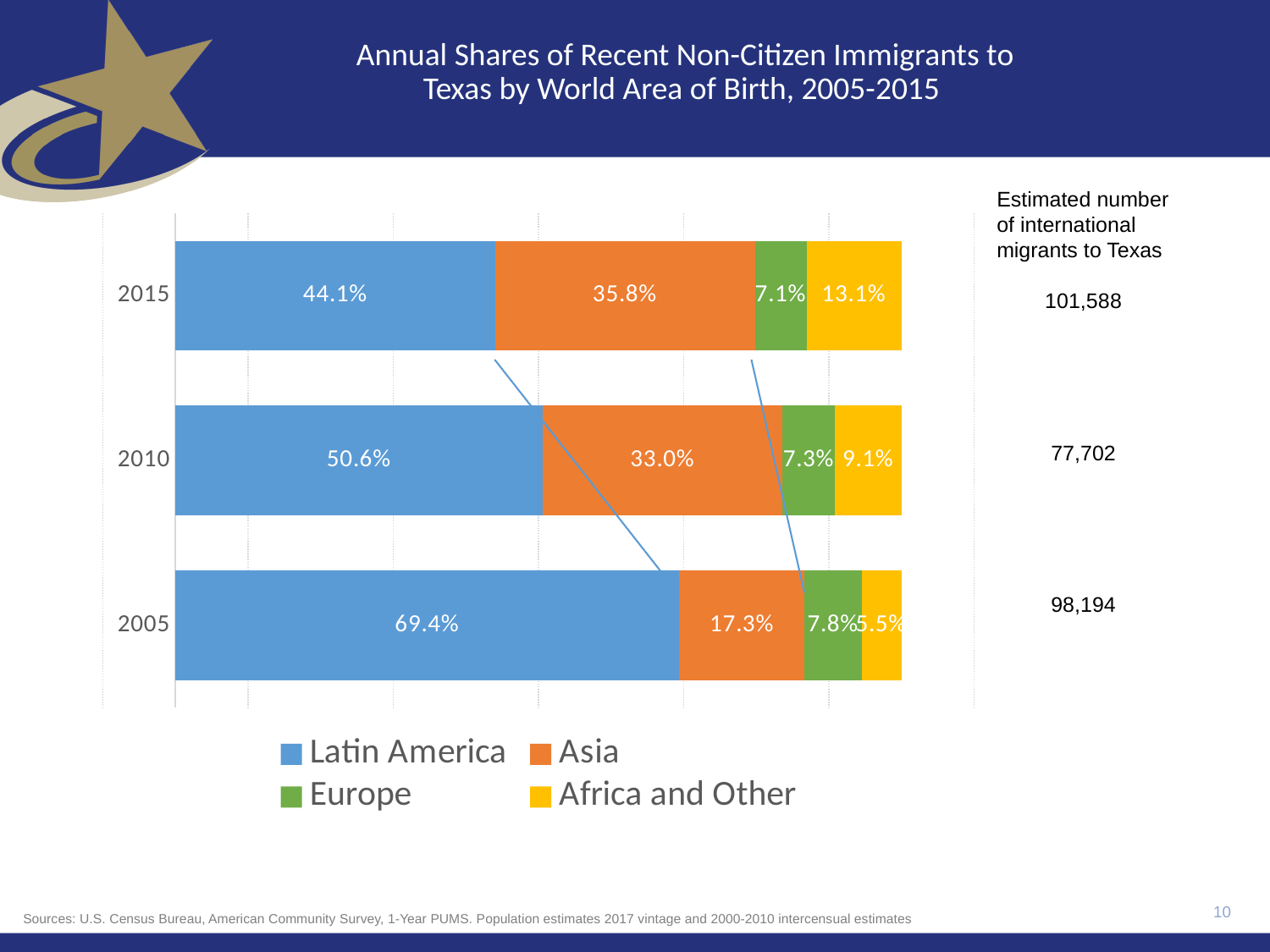
What share of recent non-citizen immigrants to Texas in 2010 were from Europe? 7.3% In which year was the Asia share the lowest? 2005 Which was larger in 2015, the Asia share or the Africa and Other share? Asia What kind of chart is shown on the slide? Stacked bar chart What share of recent non-citizen immigrants to Texas in 2010 were from Africa and Other? 9.1% How many years are shown on the chart? 3 What share of recent non-citizen immigrants to Texas in 2015 were from Latin America? 44.1% In which year was the Latin America share the highest? 2005 How many series does the legend list? 4 What is the difference between the Latin America share in 2005 and in 2015? 25.3% What share of recent non-citizen immigrants to Texas in 2005 were from Asia? 17.3% What is the estimated number of international migrants to Texas shown for 2015? 101,588